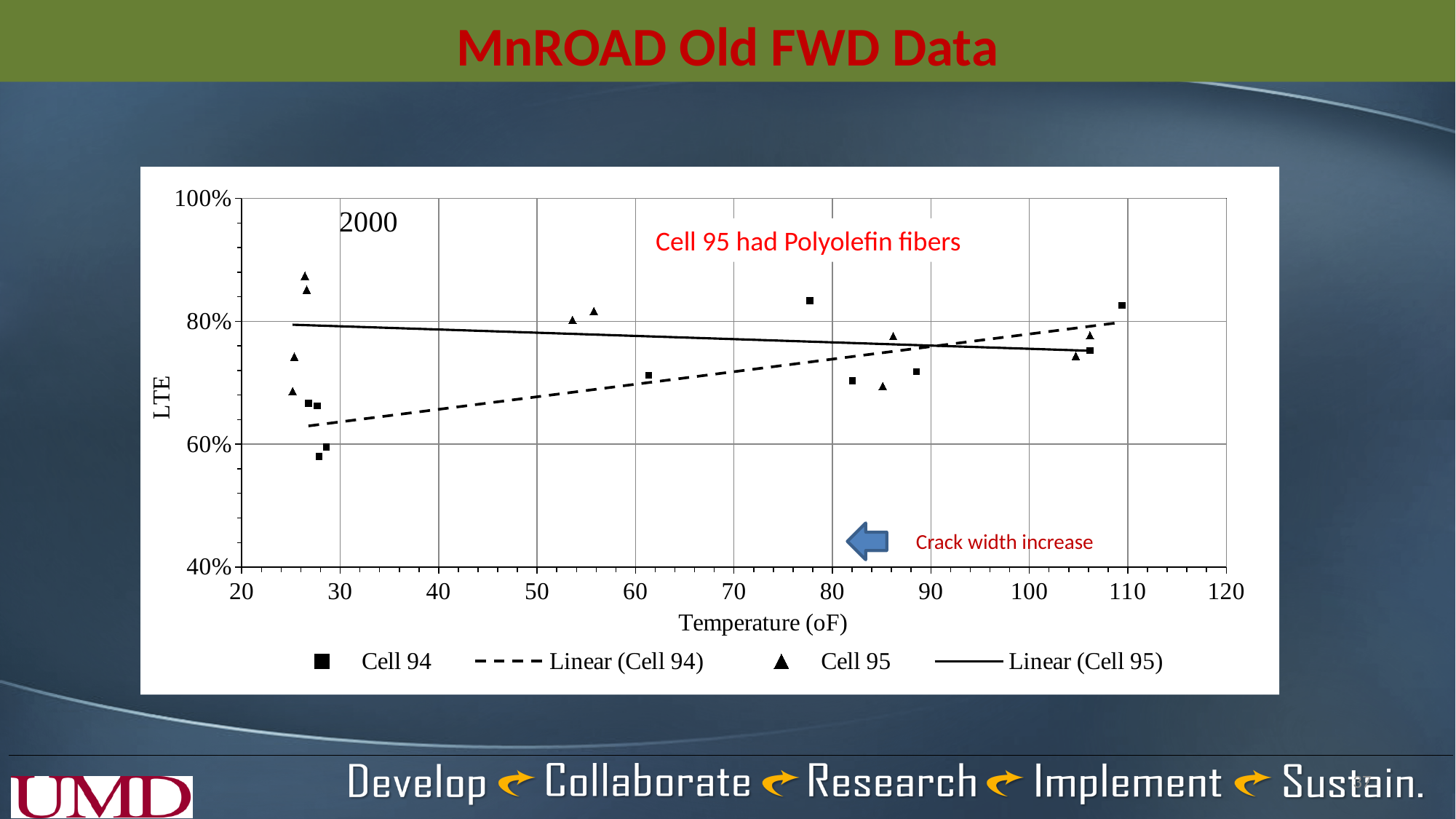
Is the Cell 94 LTE value near 78 oF greater or less than 80%? greater What is the label of the x axis of the chart? Temperature (oF) Is the Cell 95 LTE value near 85 oF greater or less than 80%? less Is the highest Cell 95 LTE value (near 26 oF) greater or less than 80%? greater What kind of chart is shown on the slide? scatter chart At 110 oF, which trendline is higher: Linear (Cell 94) or Linear (Cell 95)? Linear (Cell 94) Does the Linear (Cell 94) trendline rise or fall as temperature increases? rise Does the Linear (Cell 95) trendline rise or fall as temperature increases? fall How many entries does the chart legend list? 4 At 30 oF, which trendline is higher: Linear (Cell 94) or Linear (Cell 95)? Linear (Cell 95) What is the title of the slide containing the chart? MnROAD Old FWD Data